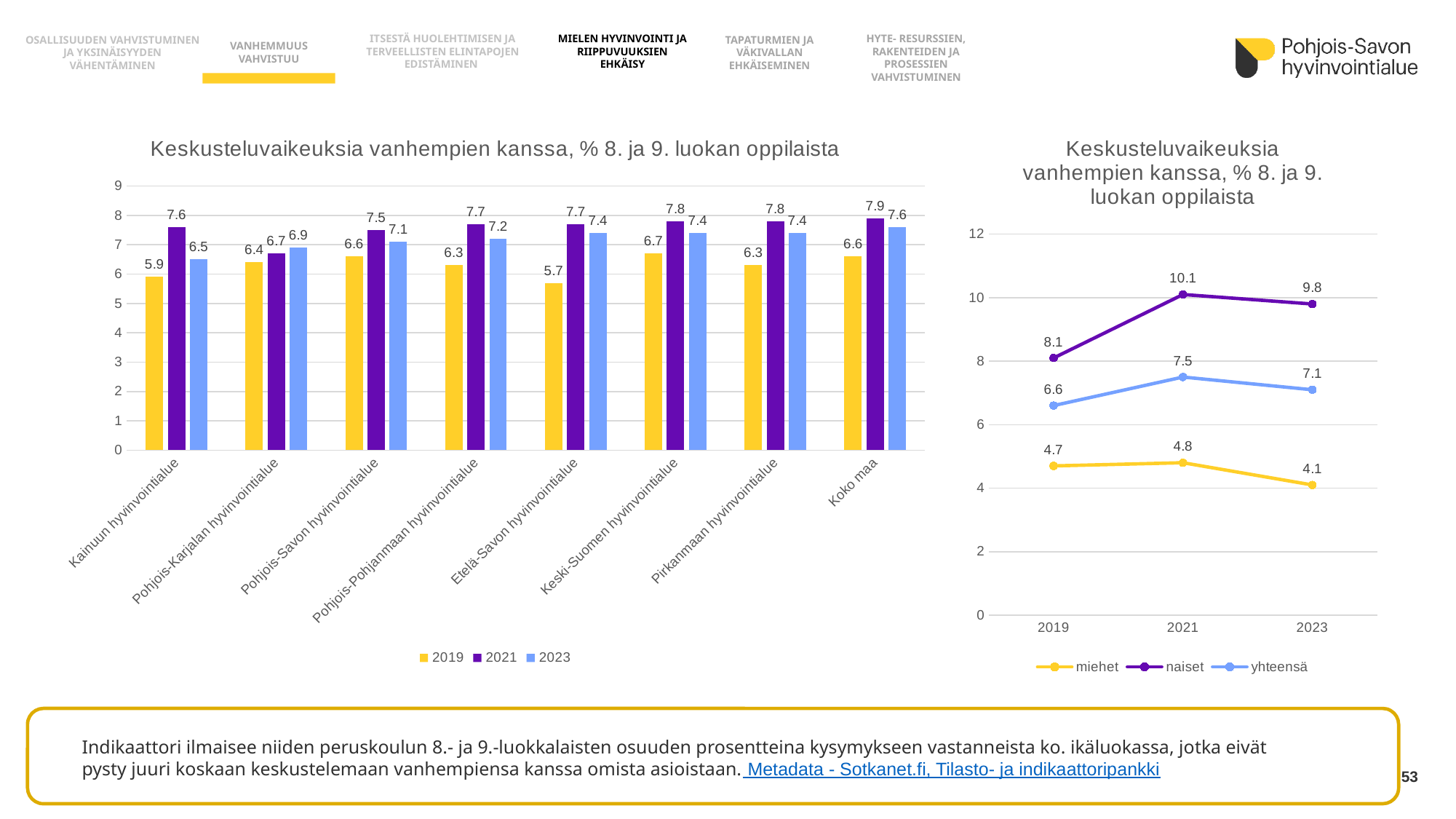
In the line chart on the right, does the miehet series rise or fall from 2021 to 2023? Fall In the bar chart on the left, what is the difference between the 2021 and 2019 values for Kainuun hyvinvointialue? 1.7 In the bar chart on the left, which category has the highest 2021 value? Koko maa In the line chart on the right, what is the value for naiset in 2021? 10.1 How many categories are shown on the x axis of the bar chart on the left? 8 How many series does the legend of the bar chart on the left list? 3 In the bar chart on the left, what is the 2021 value for Pohjois-Savon hyvinvointialue? 7.5 What kind of chart is the chart on the right of the slide? Line chart In the line chart on the right, what is the difference between the naiset and miehet values in 2023? 5.7 In the bar chart on the left, which category has the lowest 2019 value? Etelä-Savon hyvinvointialue In the bar chart on the left, what is the 2019 value for Etelä-Savon hyvinvointialue? 5.7 In the bar chart on the left, which is larger for Pohjois-Karjalan hyvinvointialue: the 2021 value or the 2023 value? 2023